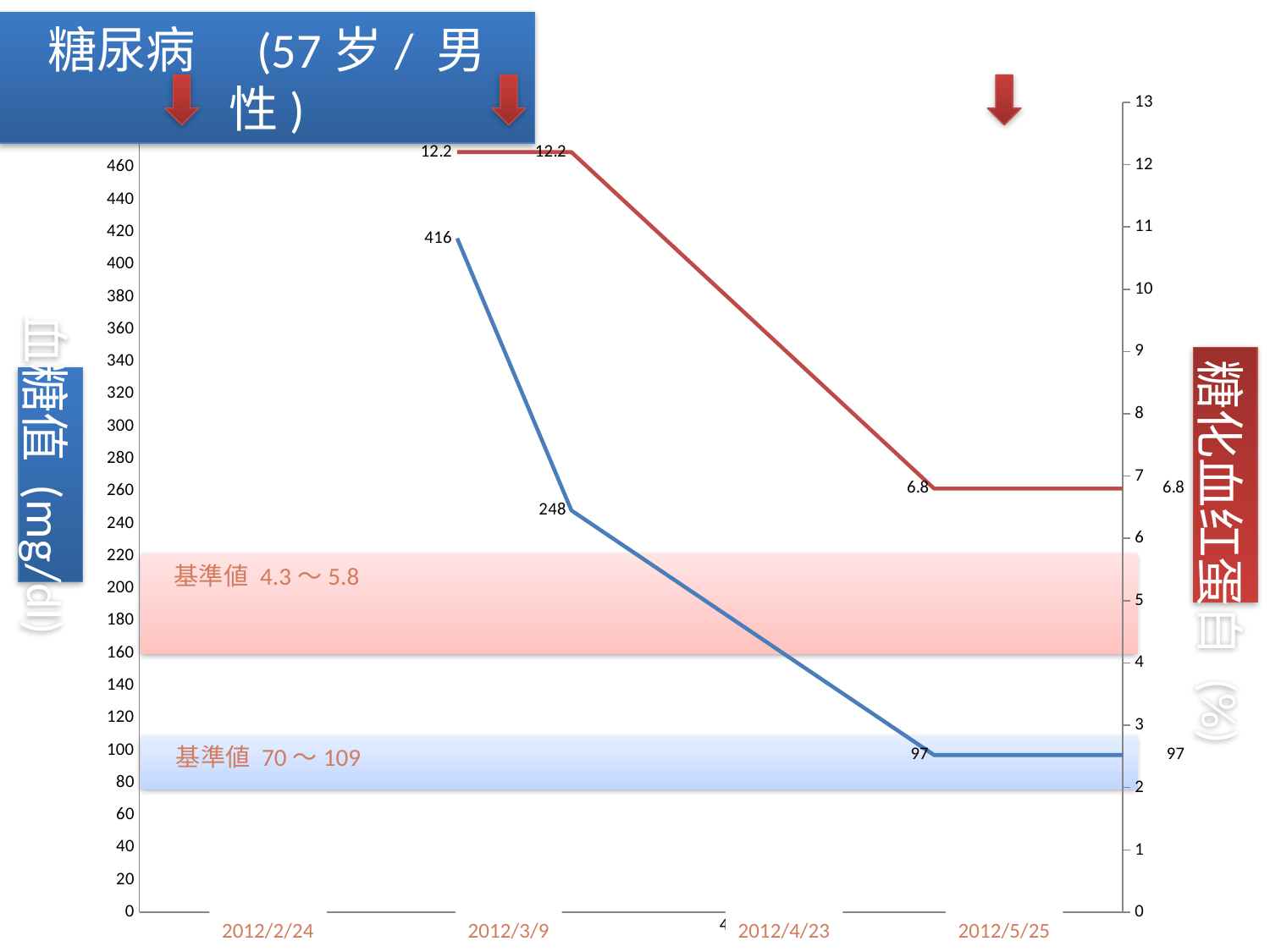
What kind of chart is shown on the slide? line chart What is the highest labeled value on the red 糖化血红蛋白 line? 12.2 What is the difference between the highest and lowest labeled values on the red line, 12.2 and 6.8? 5.4 What is the lowest labeled value on the blue 血糖値 line? 97 Do the values on the blue 血糖値 line rise or fall from left to right? fall What reference range (基準値) is shown in the blue shaded band? 70～109 What is the highest labeled value on the blue 血糖値 line? 416 How many data labels are printed along the blue 血糖値 line? 4 What reference range (基準値) is shown in the pink shaded band? 4.3～5.8 What is the difference between the labeled values 248 and 97 on the blue line? 151 What is the difference between the first two labeled values on the blue line, 416 and 248? 168 What is the lowest labeled value on the red 糖化血红蛋白 line? 6.8